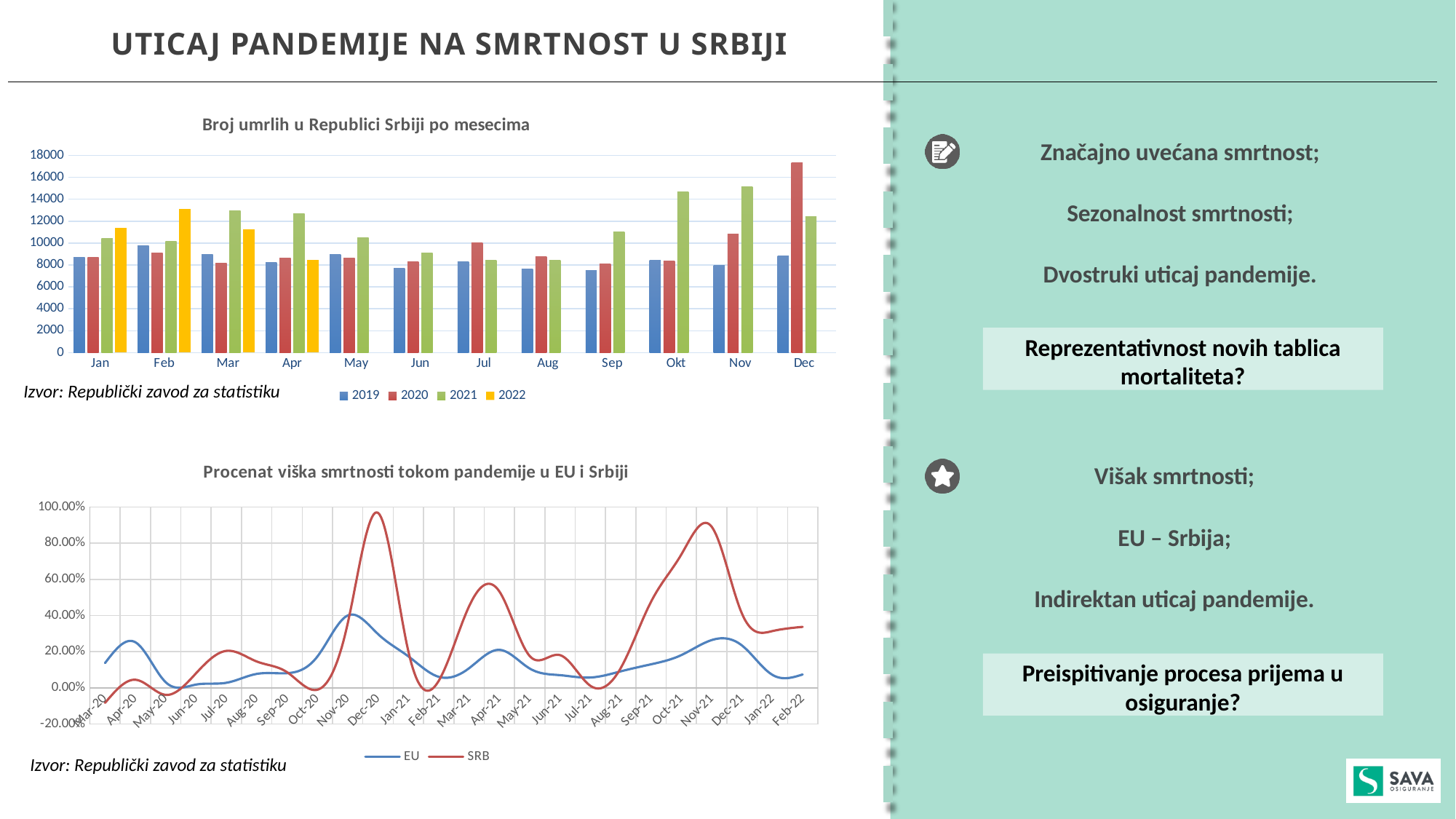
In the bottom chart 'Procenat viška smrtnosti tokom pandemije u EU i Srbiji', at which month does the SRB line reach its highest value? Dec-20 In the top chart 'Broj umrlih u Republici Srbiji po mesecima', which month has the highest value for 2020? Dec In the top chart 'Broj umrlih u Republici Srbiji po mesecima', how many series does the legend list? 4 In the top chart 'Broj umrlih u Republici Srbiji po mesecima', which month has the highest value for 2022? Feb In the bottom chart 'Procenat viška smrtnosti tokom pandemije u EU i Srbiji', is the SRB value at Dec-20 greater or less than 80.00%? greater In the bottom chart 'Procenat viška smrtnosti tokom pandemije u EU i Srbiji', how many series does the legend list? 2 In the top chart 'Broj umrlih u Republici Srbiji po mesecima', how many months are shown on the x axis? 12 In the top chart 'Broj umrlih u Republici Srbiji po mesecima', which is larger in Dec: the value for 2020 or the value for 2021? 2020 What kind of chart is the top chart titled 'Broj umrlih u Republici Srbiji po mesecima'? bar chart In the top chart 'Broj umrlih u Republici Srbiji po mesecima', is the value for 2019 in Jan greater or less than 10000? less What kind of chart is the bottom chart titled 'Procenat viška smrtnosti tokom pandemije u EU i Srbiji'? line chart In the top chart 'Broj umrlih u Republici Srbiji po mesecima', is the value for 2020 in Dec greater or less than 16000? greater